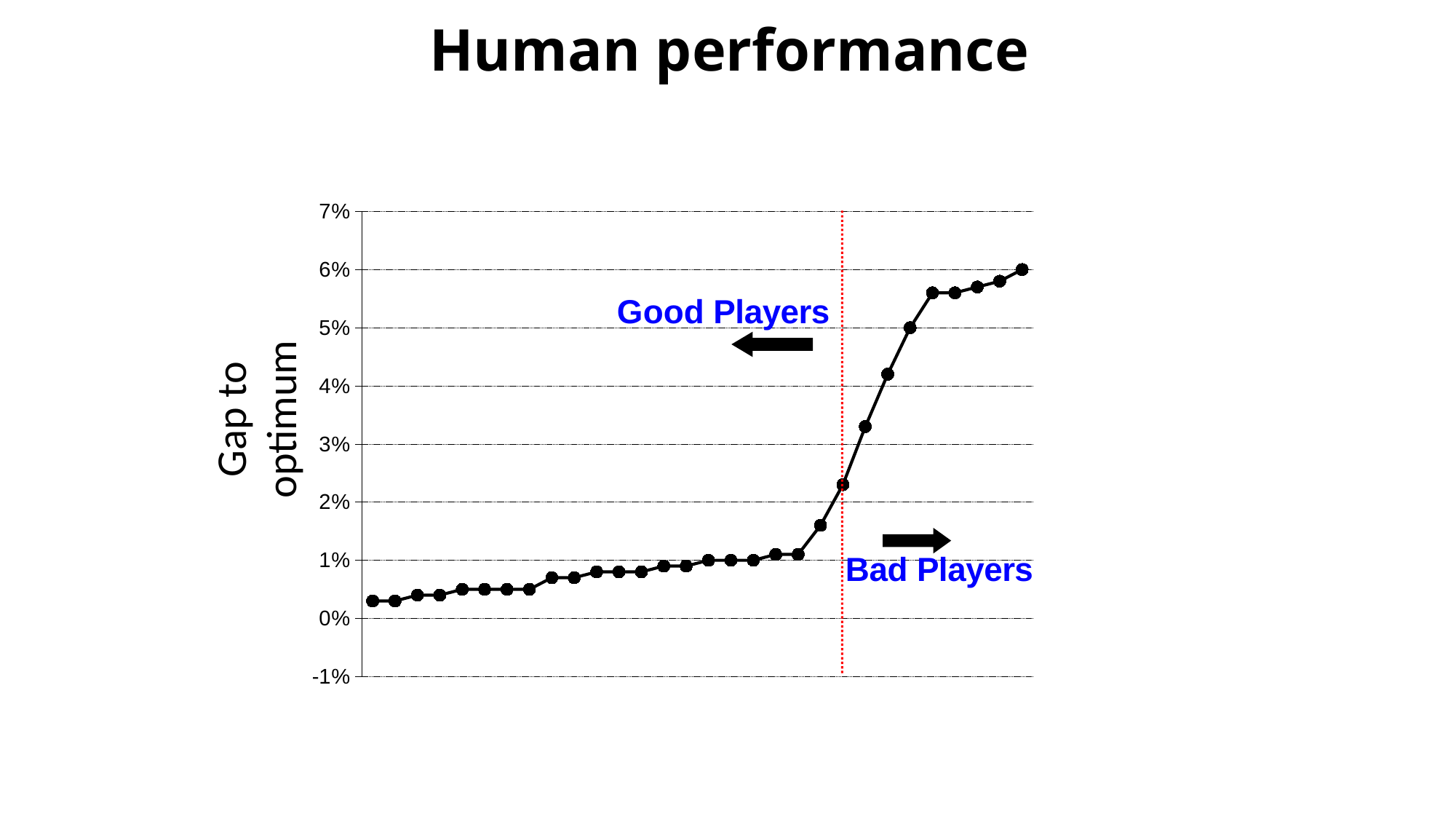
Which point on the line has the lowest value, the leftmost or the rightmost? leftmost What is the highest value shown on the vertical axis? 7% Is the value of the rightmost point on the line greater or less than 5%? greater What is the title of the chart on the slide? Human performance Is the value of the first point to the right of the red dotted line greater or less than 2%? greater Which side of the red dotted line is labelled 'Good Players'? left Is the value of the leftmost point on the line greater or less than 1%? less Which point on the line has the highest value, the leftmost or the rightmost? rightmost What kind of chart is shown on the slide? line chart Do the plotted values rise or fall from left to right along the x axis? rise